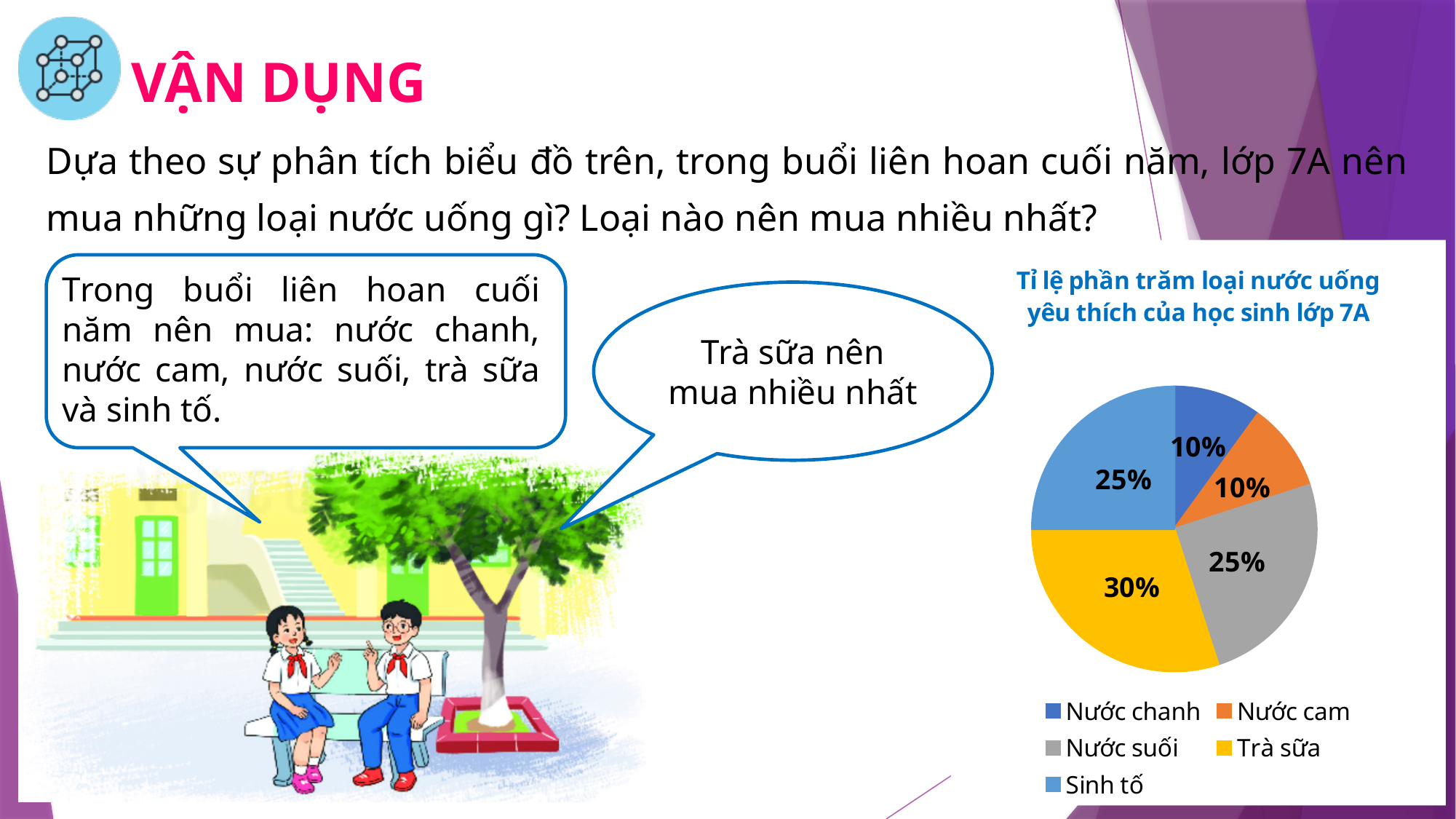
What percentage of the pie chart is Sinh tố? 25% What is the difference in percentage between Sinh tố and Nước cam? 15% What is the title of the chart? Tỉ lệ phần trăm loại nước uống yêu thích của học sinh lớp 7A What is the difference in percentage between Trà sữa and Nước suối? 5% What type of chart is shown on the slide? Pie chart Which drink has the largest share of the pie chart? Trà sữa What percentage of the pie chart is Nước suối? 25% What percentage of the pie chart is Trà sữa? 30% How many categories does the pie chart show? 5 What percentage of the pie chart is Nước cam? 10% Which has a larger share, Trà sữa or Sinh tố? Trà sữa What percentage of the pie chart is Nước chanh? 10%